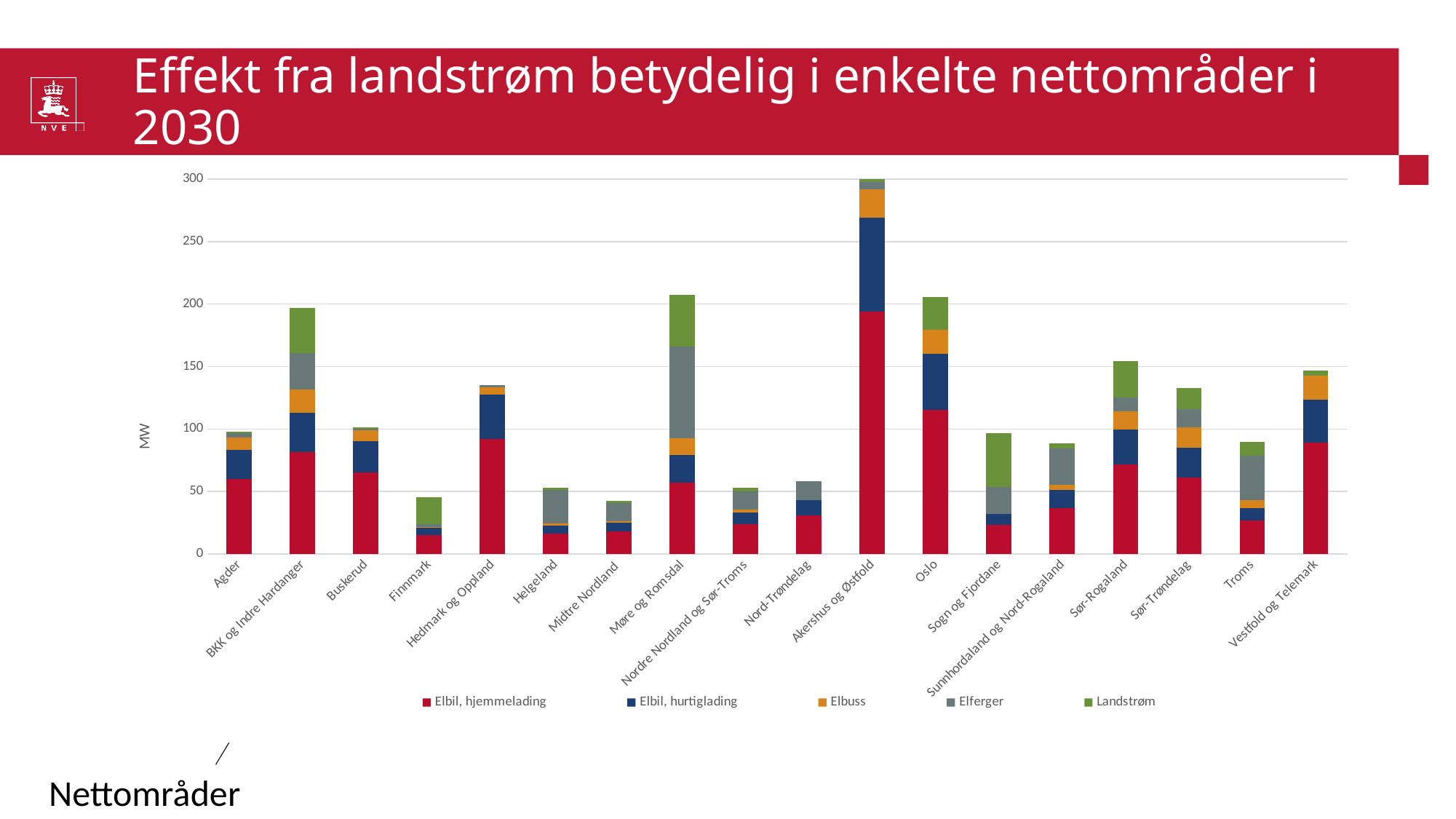
Which nettområde has the highest total bar? Akershus og Østfold Which has the larger total bar, Møre og Romsdal or Buskerud? Møre og Romsdal Is the total value for Akershus og Østfold greater or less than 250? greater Is the total value for Møre og Romsdal greater or less than 150? greater Is the total value for Finnmark greater or less than 50? less What unit is shown on the y axis? MW Which series is shown in green in the legend? Landstrøm What kind of chart is shown on the slide? Stacked bar chart Which has the larger total bar, Akershus og Østfold or Oslo? Akershus og Østfold How many series does the legend list? 5 How many nettområder (categories) are shown on the x axis? 18